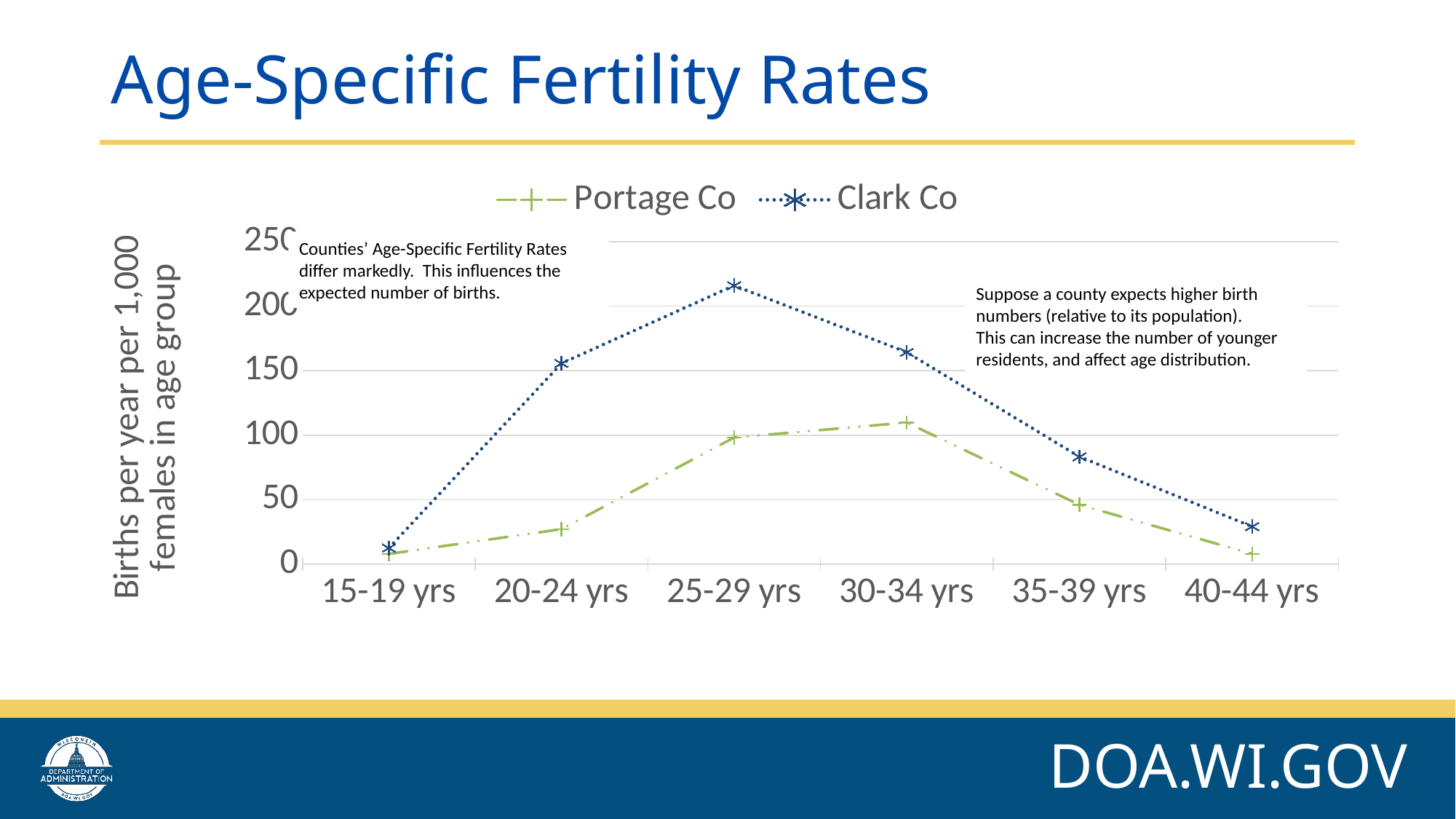
Is the value for Clark Co at 35-39 yrs greater or less than 100? less Which age group has the highest value for Portage Co? 30-34 yrs What is the label on the y axis? Births per year per 1,000 females in age group What kind of chart is shown on the slide? line chart At 25-29 yrs, which series has the larger value, Portage Co or Clark Co? Clark Co Is the value for Clark Co at 25-29 yrs greater or less than 200? greater How many series does the legend list? 2 How many age groups are shown on the x axis? 6 Which age group has the lowest value for Clark Co? 15-19 yrs Which age group has the highest value for Clark Co? 25-29 yrs Is the value for Portage Co at 20-24 yrs greater or less than 50? less Do the values for Clark Co rise or fall from 25-29 yrs to 40-44 yrs? fall